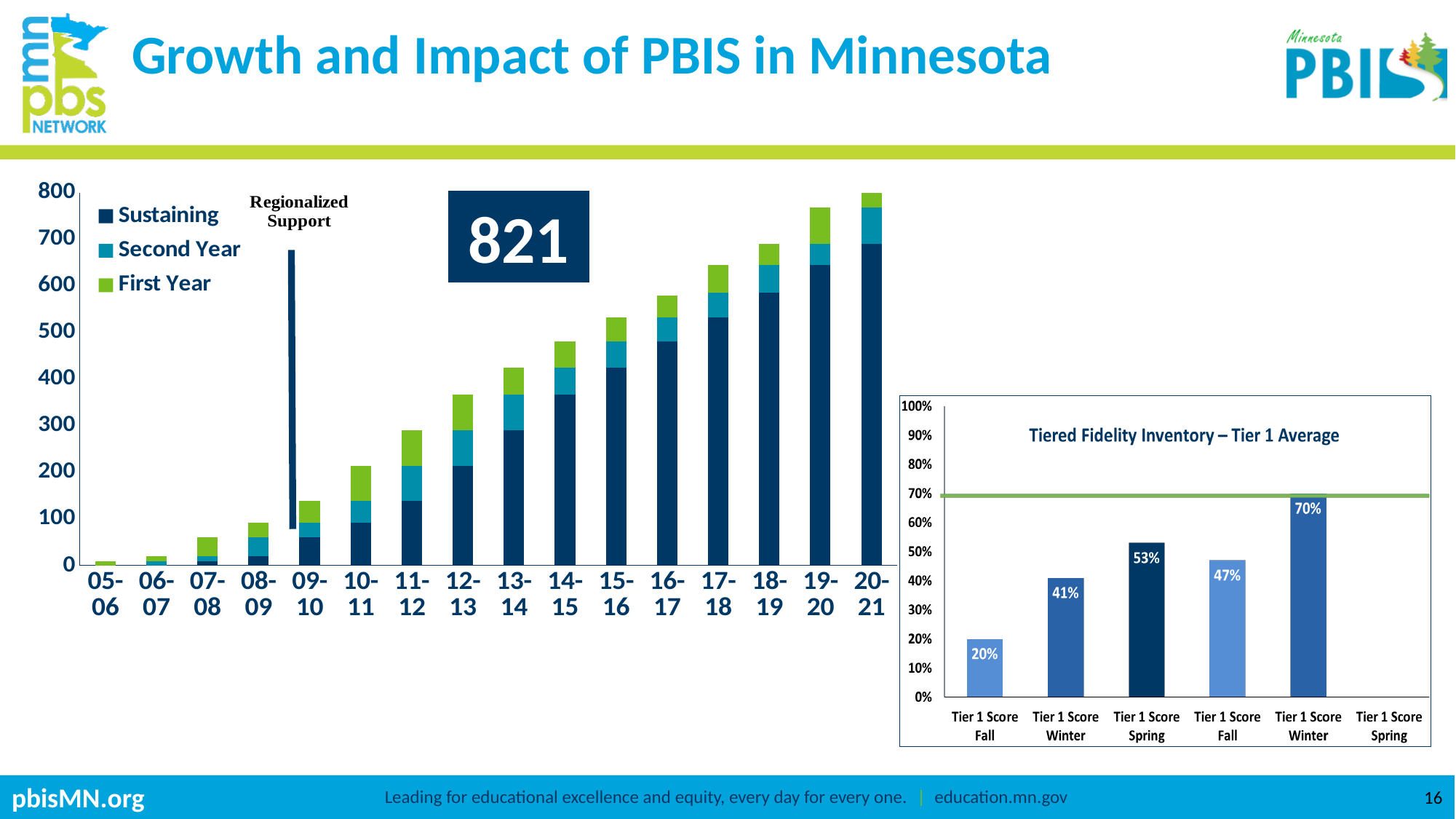
In the Tiered Fidelity Inventory – Tier 1 Average chart, what is the value for Tier 1 Score Spring (the third bar)? 53% In the Tiered Fidelity Inventory – Tier 1 Average chart, which bar has the lowest value? Tier 1 Score Fall (the first bar), 20% In the Tiered Fidelity Inventory – Tier 1 Average chart, what is the difference between the third bar (Tier 1 Score Spring, 53%) and the second bar (Tier 1 Score Winter, 41%)? 12% In the stacked bar chart on the left, do the bar totals generally rise or fall from 05-06 to 20-21? rise In the stacked bar chart on the left, is the total for 20-21 greater or less than 700? greater In the stacked bar chart on the left, how many school-year categories are shown on the x axis? 16 In the Tiered Fidelity Inventory – Tier 1 Average chart, what is the value for the second Tier 1 Score Winter bar (the fifth bar)? 70% In the Tiered Fidelity Inventory – Tier 1 Average chart, which is larger: the third bar (Tier 1 Score Spring) or the fourth bar (Tier 1 Score Fall)? Tier 1 Score Spring (third bar), 53% In the Tiered Fidelity Inventory – Tier 1 Average chart, which bar has the highest value? Tier 1 Score Winter (the fifth bar), 70% In the Tiered Fidelity Inventory – Tier 1 Average chart, how many bars are plotted? 5 In the Tiered Fidelity Inventory – Tier 1 Average chart, what is the value for the first Tier 1 Score Fall bar? 20% In the stacked bar chart on the left, how many series does the legend list? 3